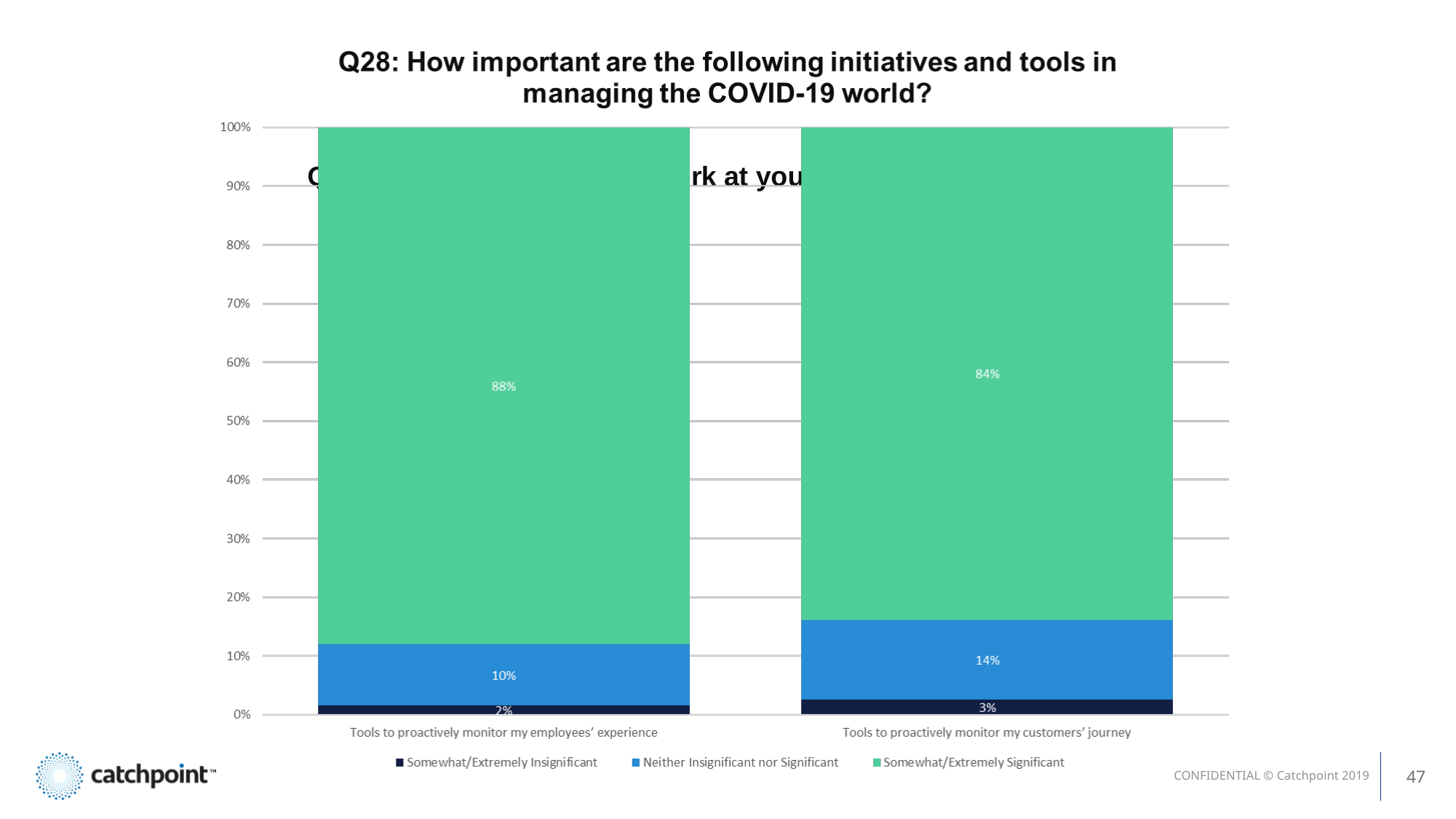
Which colour represents the Somewhat/Extremely Significant series? Green What is the Neither Insignificant nor Significant value for tools to proactively monitor my customers' journey? 14% What percentage of respondents rated tools to proactively monitor my employees' experience as Somewhat/Extremely Significant? 88% What is the Somewhat/Extremely Insignificant value for tools to proactively monitor my employees' experience? 2% Is the Neither Insignificant nor Significant share larger for employees' experience or customers' journey? Tools to proactively monitor my customers' journey How many categories are shown on the x axis? 2 What is the Somewhat/Extremely Insignificant value for tools to proactively monitor my customers' journey? 3% Which category has the higher Somewhat/Extremely Significant share? Tools to proactively monitor my employees' experience What is the difference between the Somewhat/Extremely Significant shares for the two categories? 4% What percentage of respondents rated tools to proactively monitor my customers' journey as Somewhat/Extremely Significant? 84% What kind of chart is shown on the slide? Stacked bar chart How many series does the legend list? 3